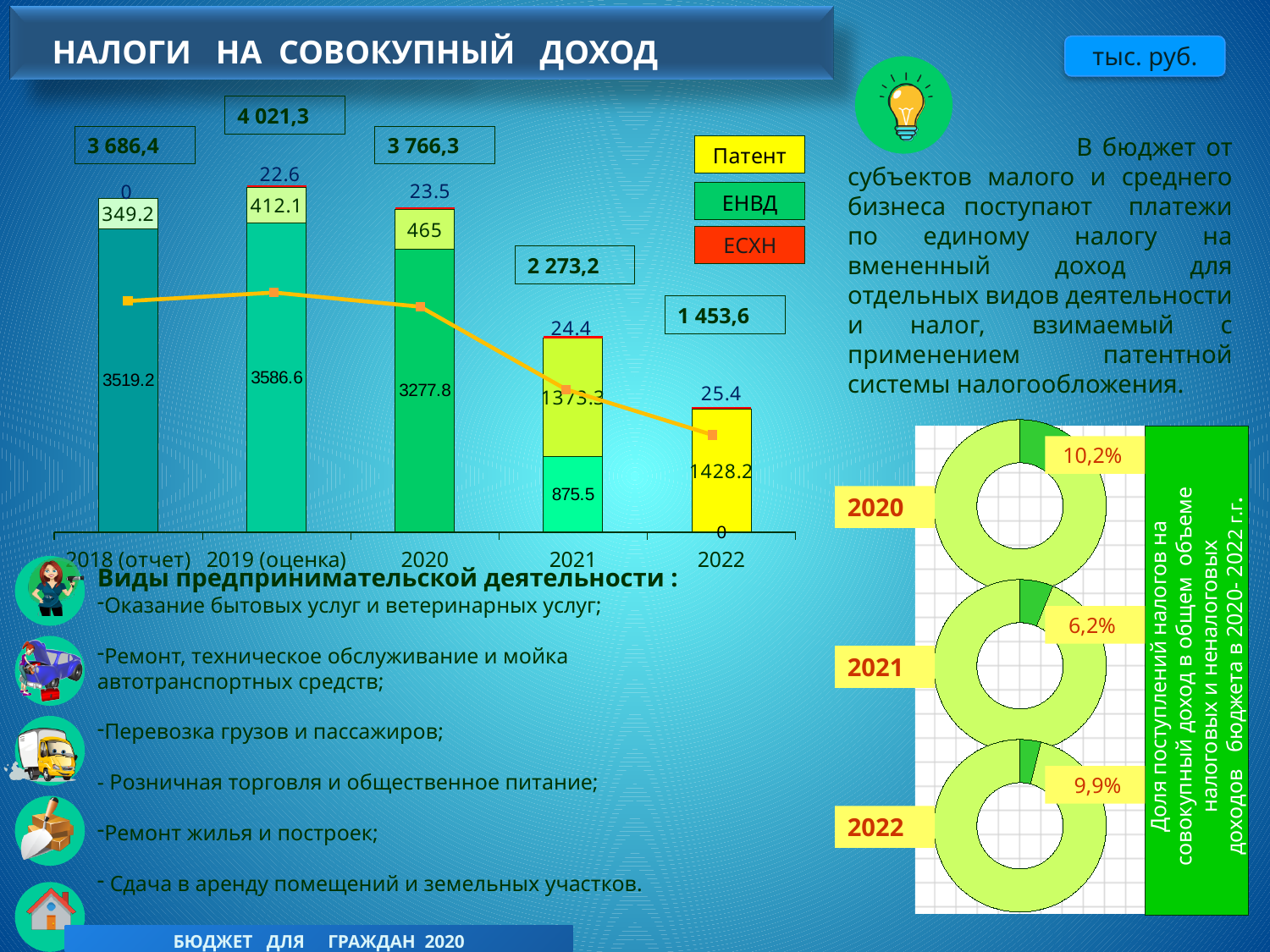
How many series does the legend of the bar chart 'НАЛОГИ НА СОВОКУПНЫЙ ДОХОД' list? 3 In the bar chart 'НАЛОГИ НА СОВОКУПНЫЙ ДОХОД', what is the value of ЕСХН for 2021? 24.4 In the bar chart 'НАЛОГИ НА СОВОКУПНЫЙ ДОХОД', which year has the lowest total? 2022 In the bar chart 'НАЛОГИ НА СОВОКУПНЫЙ ДОХОД', what is the value of Патент for 2022? 1428.2 In the bar chart 'НАЛОГИ НА СОВОКУПНЫЙ ДОХОД', what is the total of the stacked bar for 2020? 3 766,3 In the donut charts on the right of the slide, what share is shown for 2021? 6,2% In the bar chart 'НАЛОГИ НА СОВОКУПНЫЙ ДОХОД', which year has the highest total? 2019 (оценка) In the bar chart 'НАЛОГИ НА СОВОКУПНЫЙ ДОХОД', do the Патент values rise or fall from 2018 to 2022? rise In the bar chart 'НАЛОГИ НА СОВОКУПНЫЙ ДОХОД', what is the difference between the Патент values for 2021 and 2020? 908.3 In the bar chart 'НАЛОГИ НА СОВОКУПНЫЙ ДОХОД', is the ЕНВД value larger in 2020 or in 2021? 2020 How many years are shown on the x axis of the bar chart 'НАЛОГИ НА СОВОКУПНЫЙ ДОХОД'? 5 In the bar chart 'НАЛОГИ НА СОВОКУПНЫЙ ДОХОД', what is the value of ЕНВД for 2019 (оценка)? 3586.6